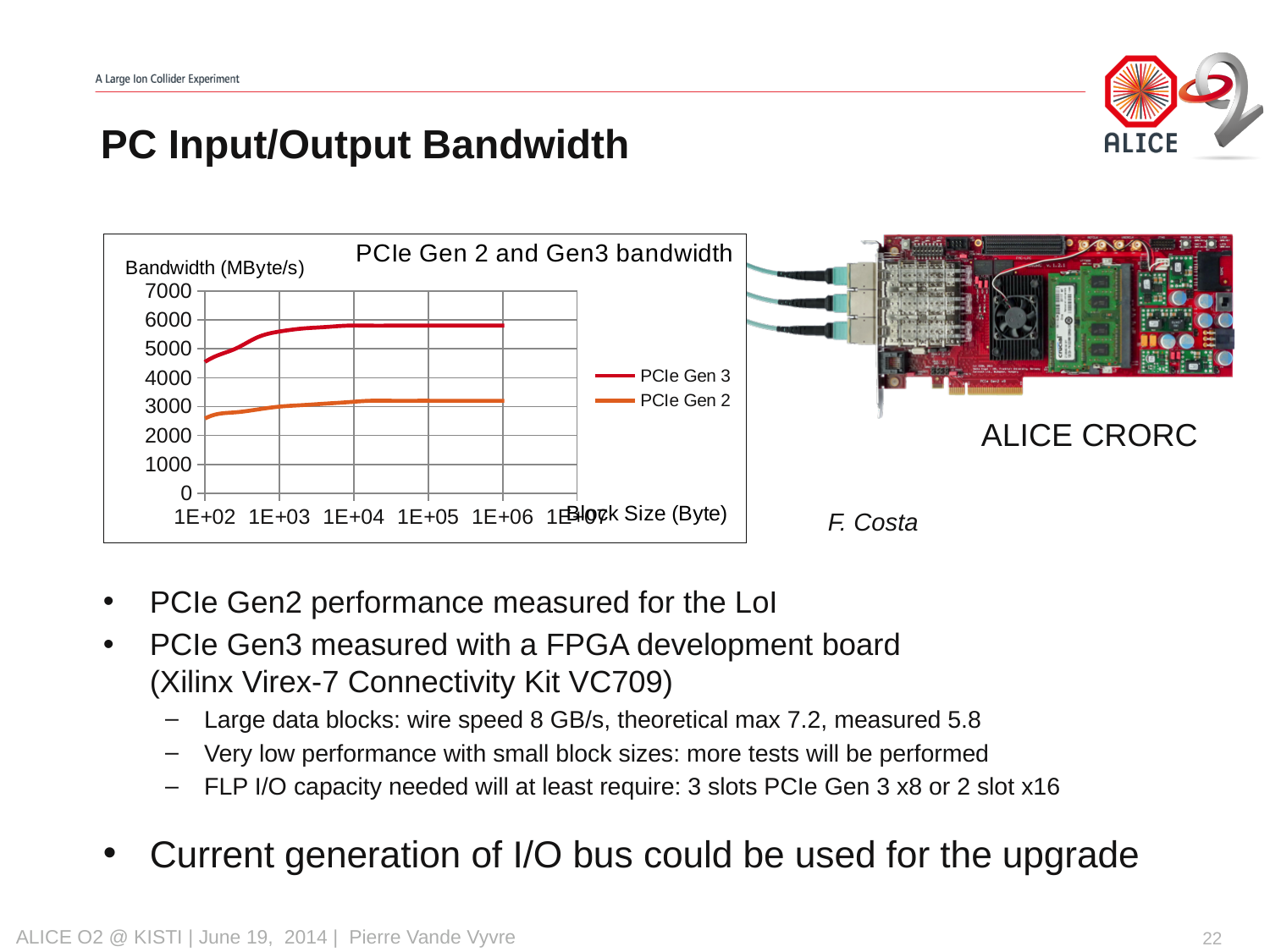
Does the PCIe Gen 3 bandwidth rise or fall as block size increases along the x axis? rise How many series does the chart's legend list? 2 What kind of chart is shown on the slide? line chart What is the label of the chart's y axis? Bandwidth (MByte/s) Is the PCIe Gen 3 bandwidth at block size 1E+02 greater or less than 4000? greater What is the title of the chart? PCIe Gen 2 and Gen3 bandwidth Does the PCIe Gen 2 bandwidth rise or fall as block size increases along the x axis? rise Is the PCIe Gen 2 bandwidth at block size 1E+02 greater or less than 3000? less Which series has the higher bandwidth across the block sizes, PCIe Gen 3 or PCIe Gen 2? PCIe Gen 3 Is the PCIe Gen 3 bandwidth at block size 1E+06 greater or less than 5000? greater Which series is plotted with the lower line on the chart? PCIe Gen 2